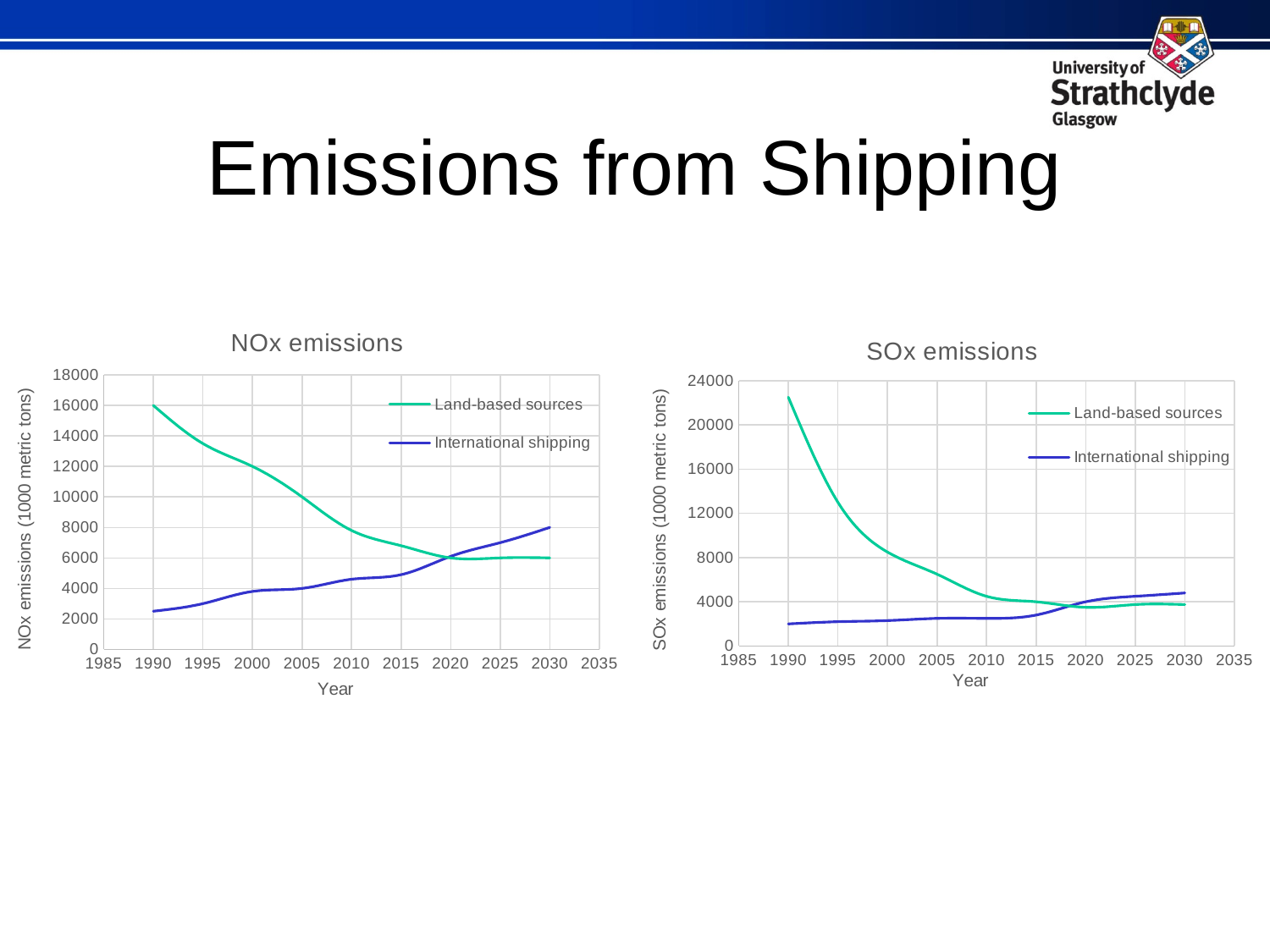
What are the two series named in the legend of the NOx emissions chart? Land-based sources and International shipping In the NOx emissions chart, is the value for International shipping in 1990 greater or less than 4000? less In the SOx emissions chart, which series has the larger value in 2000, Land-based sources or International shipping? Land-based sources In the NOx emissions chart, does the Land-based sources line rise or fall from 1990 to 2030? fall In the NOx emissions chart, is the value for Land-based sources in 1990 greater or less than 14000? greater In the SOx emissions chart, is the value for Land-based sources in 1990 greater or less than 20000? greater In the NOx emissions chart, which series has the larger value in 2030, Land-based sources or International shipping? International shipping What kind of chart is the NOx emissions chart? line chart How many series does the legend of the SOx emissions chart list? 2 What is the y-axis label of the SOx emissions chart? SOx emissions (1000 metric tons) In the NOx emissions chart, does the International shipping line rise or fall from 1990 to 2030? rise